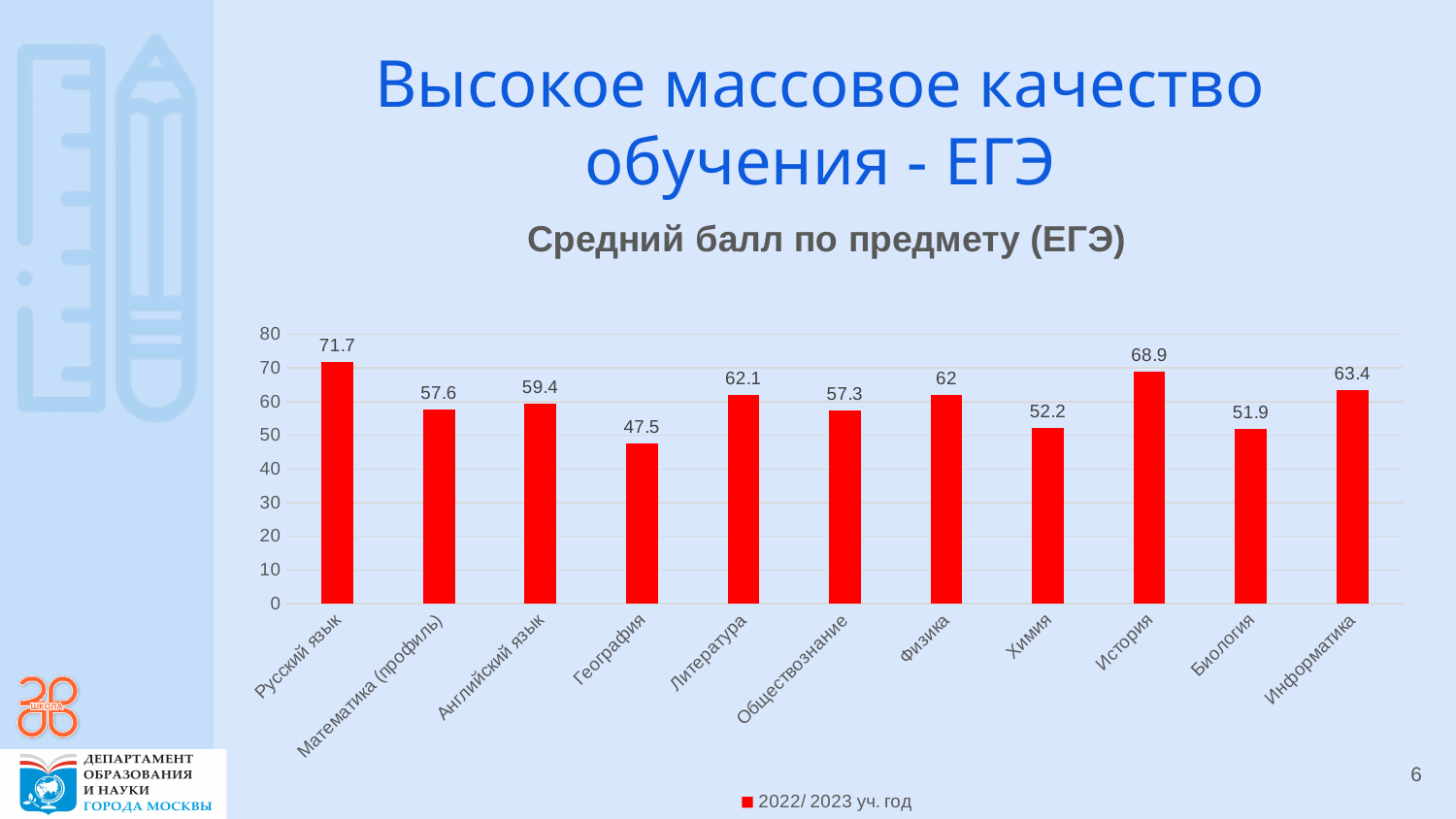
What is the title of the chart? Средний балл по предмету (ЕГЭ) How many series does the legend list? 1 Which has a higher average score, Физика or Химия? Физика Which subject has the highest average score? Русский язык Which subject has the lowest average score? География How many subjects are shown in the chart? 11 Is the value for Информатика greater or less than 60? greater What is the average score for География? 47.5 What kind of chart is shown on the slide? bar chart What is the difference between the average scores for Русский язык and География? 24.2 What is the average score for История? 68.9 What is the average score for Русский язык? 71.7